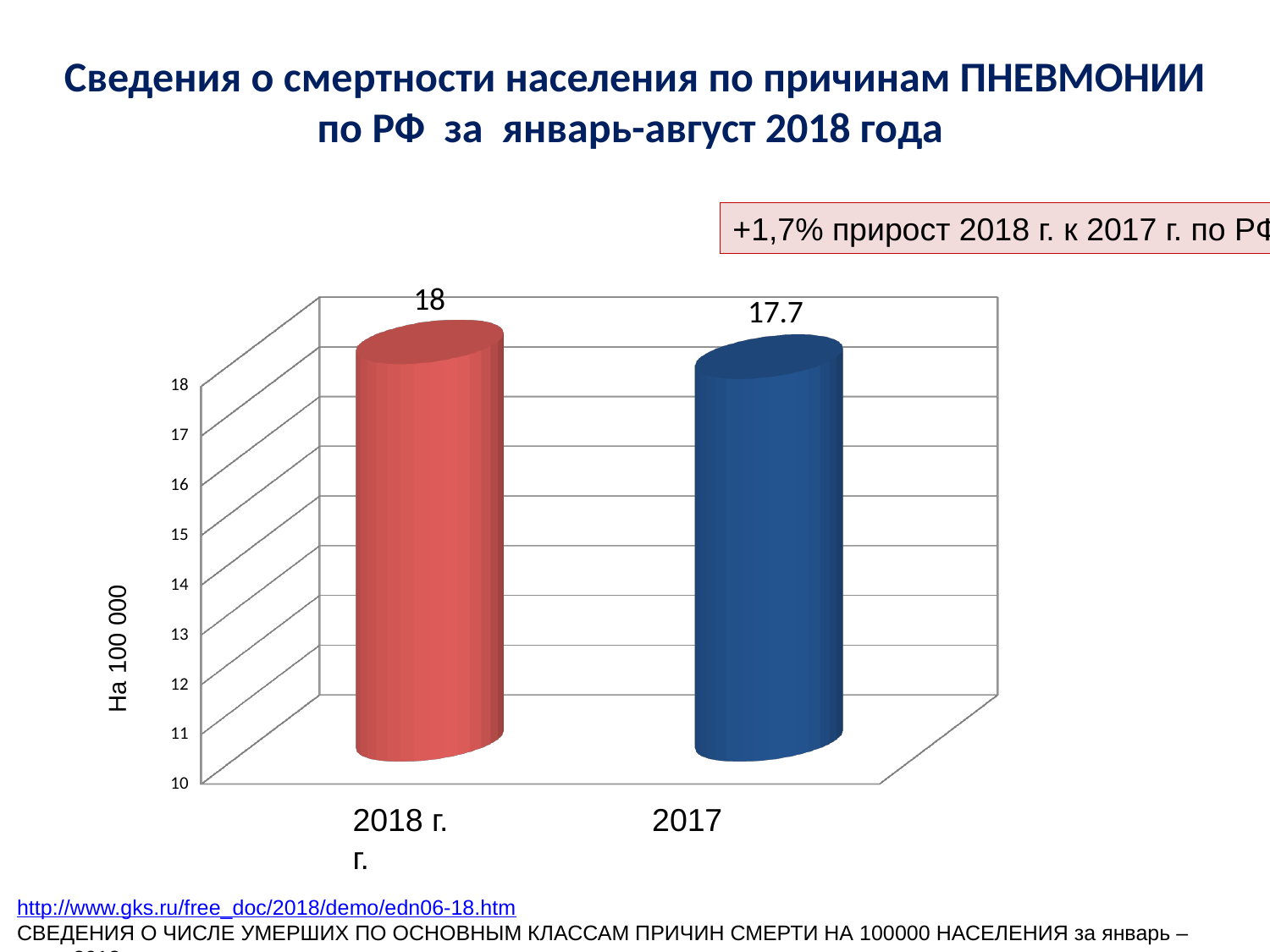
What is the value for 2018 г.? 18 Which year has the higher value? 2018 г. Is the value for 2017 г. greater or less than 15? greater What is the label of the vertical axis? На 100 000 What is the difference between the values for 2018 г. and 2017 г.? 0.3 How many categories are shown on the x axis? 2 Do the values fall or rise from 2018 г. to 2017 г. along the x axis? fall Is the value for 2018 г. larger or smaller than the value for 2017 г.? larger Which year has the lower value? 2017 г. What kind of chart is shown on the slide? bar chart What colour is the bar for 2017 г.? blue What is the value for 2017 г.? 17.7